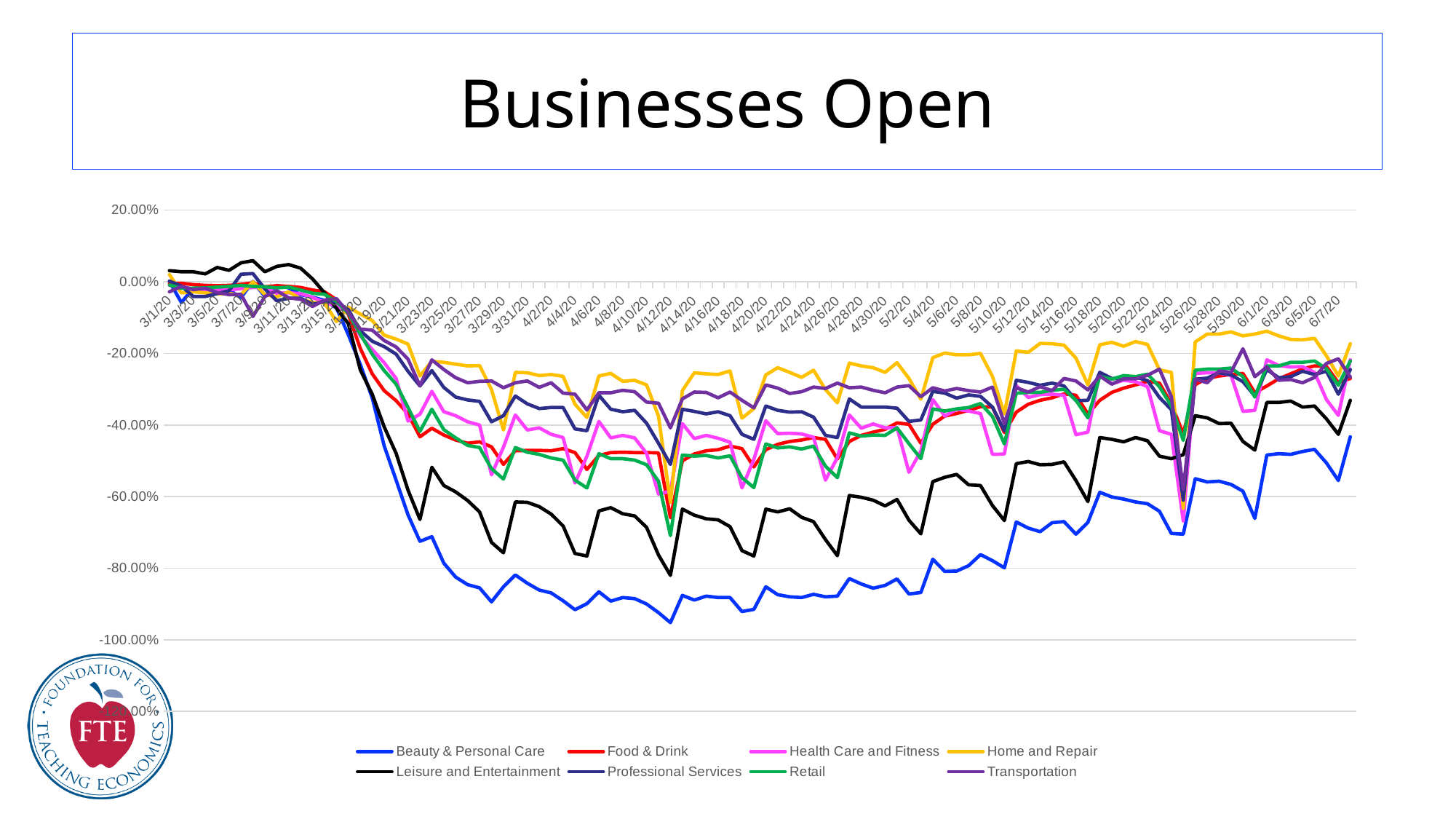
Which series reaches the lowest value on the chart? Beauty & Personal Care From mid-April to early June, does the Beauty & Personal Care line rise or fall overall? rise What kind of chart is shown on the slide? line chart Between 3/15/20 and 3/25/20, do the values for the series rise or fall? fall Is the value for Beauty & Personal Care around 4/12/20 greater or less than -80.00%? less What colour is the Beauty & Personal Care line in the legend? blue Is the value for Leisure and Entertainment around 4/12/20 greater or less than -60.00%? less What is the title of the chart? Businesses Open Around 4/12/20, which series is lower: Beauty & Personal Care or Leisure and Entertainment? Beauty & Personal Care How many series does the legend list? 8